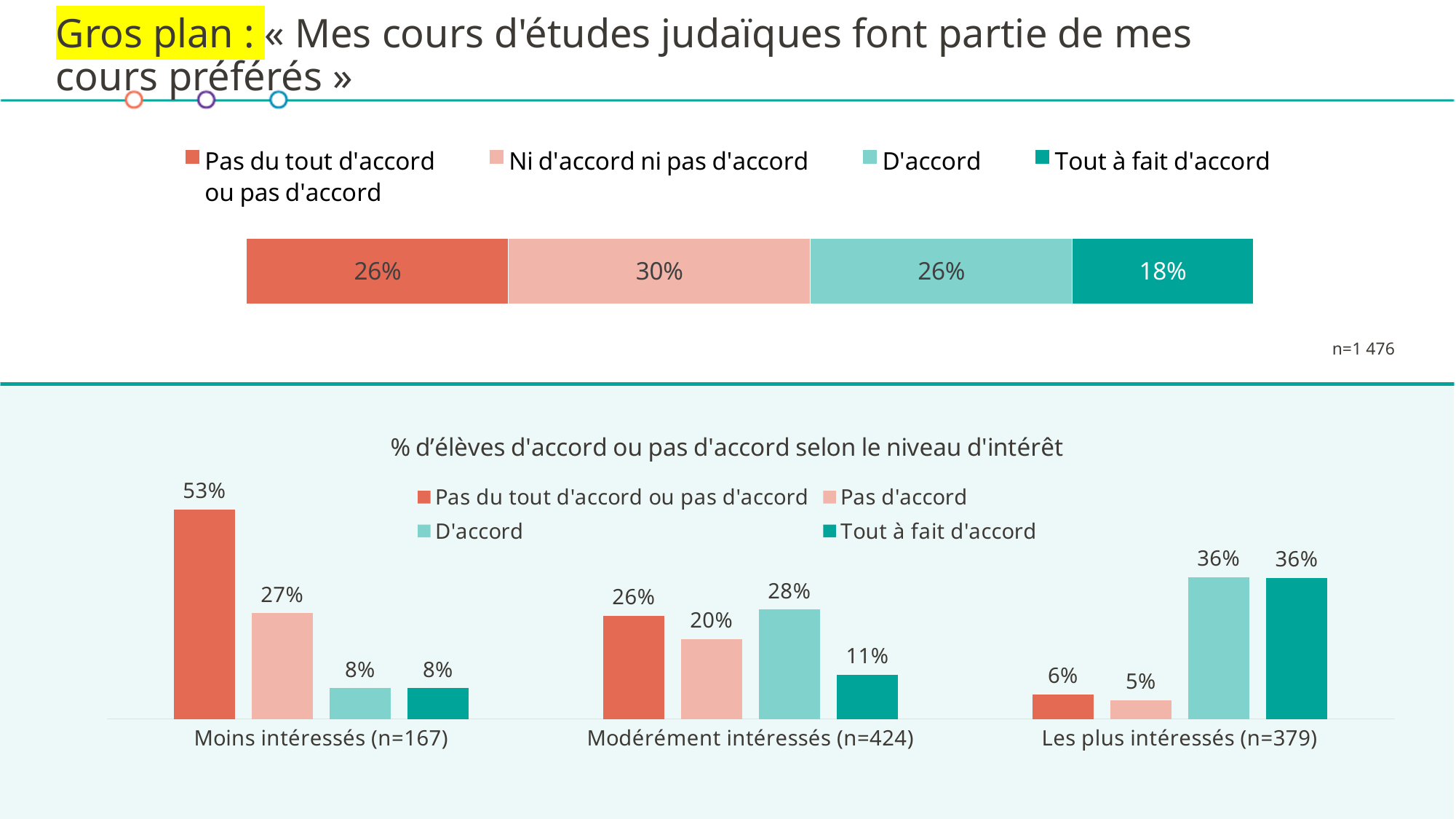
In the bottom chart "% d'élèves d'accord ou pas d'accord selon le niveau d'intérêt", what is the difference between "D'accord" and "Pas d'accord" among "Les plus intéressés (n=379)"? 31% What sample size (n) is shown for the top stacked bar chart? n=1 476 In the top stacked bar chart, what is the combined percentage of "D'accord" and "Tout à fait d'accord"? 44% In the top stacked bar chart, which response category has the largest share? Ni d'accord ni pas d'accord In the bottom chart "% d'élèves d'accord ou pas d'accord selon le niveau d'intérêt", what is the value for "Pas du tout d'accord ou pas d'accord" among "Moins intéressés (n=167)"? 53% In the bottom chart "% d'élèves d'accord ou pas d'accord selon le niveau d'intérêt", how many interest-level groups are shown on the x axis? 3 In the bottom chart "% d'élèves d'accord ou pas d'accord selon le niveau d'intérêt", which is larger among "Modérément intéressés (n=424)": "Pas du tout d'accord ou pas d'accord" or "D'accord"? D'accord In the bottom chart "% d'élèves d'accord ou pas d'accord selon le niveau d'intérêt", what is the value for "Tout à fait d'accord" among "Modérément intéressés (n=424)"? 11% In the top stacked bar chart, how many response categories does the legend list? 4 In the bottom chart "% d'élèves d'accord ou pas d'accord selon le niveau d'intérêt", how does the value for "Pas du tout d'accord ou pas d'accord" change from "Moins intéressés" to "Les plus intéressés"? It falls In the bottom chart "% d'élèves d'accord ou pas d'accord selon le niveau d'intérêt", what kind of chart is it? Bar chart In the top stacked bar chart, what percentage of students answered "Tout à fait d'accord"? 18%